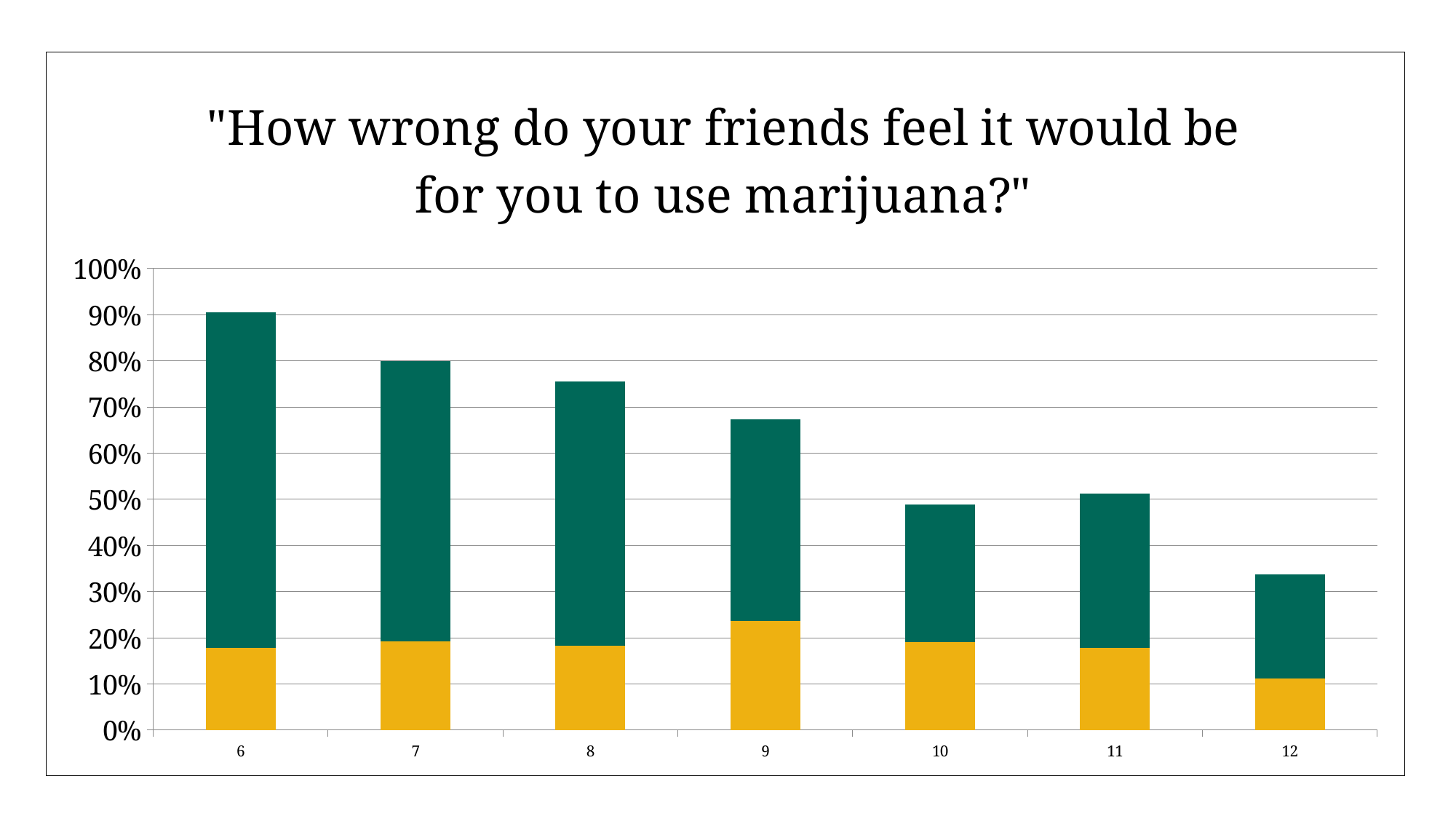
Is the total bar height for category 6 greater or less than 80%? greater Which category has the shortest bar overall? 12 Is the total bar height for category 9 greater or less than 70%? less Which has the taller bar overall, category 8 or category 9? 8 Which category has the tallest bar overall? 6 What is the title of the chart? "How wrong do your friends feel it would be for you to use marijuana?" Is the total bar height for category 9 greater or less than 60%? greater What kind of chart is shown on the slide? stacked bar chart How many categories are shown along the x axis? 7 Do the total bar heights generally rise or fall from category 6 to category 12? fall